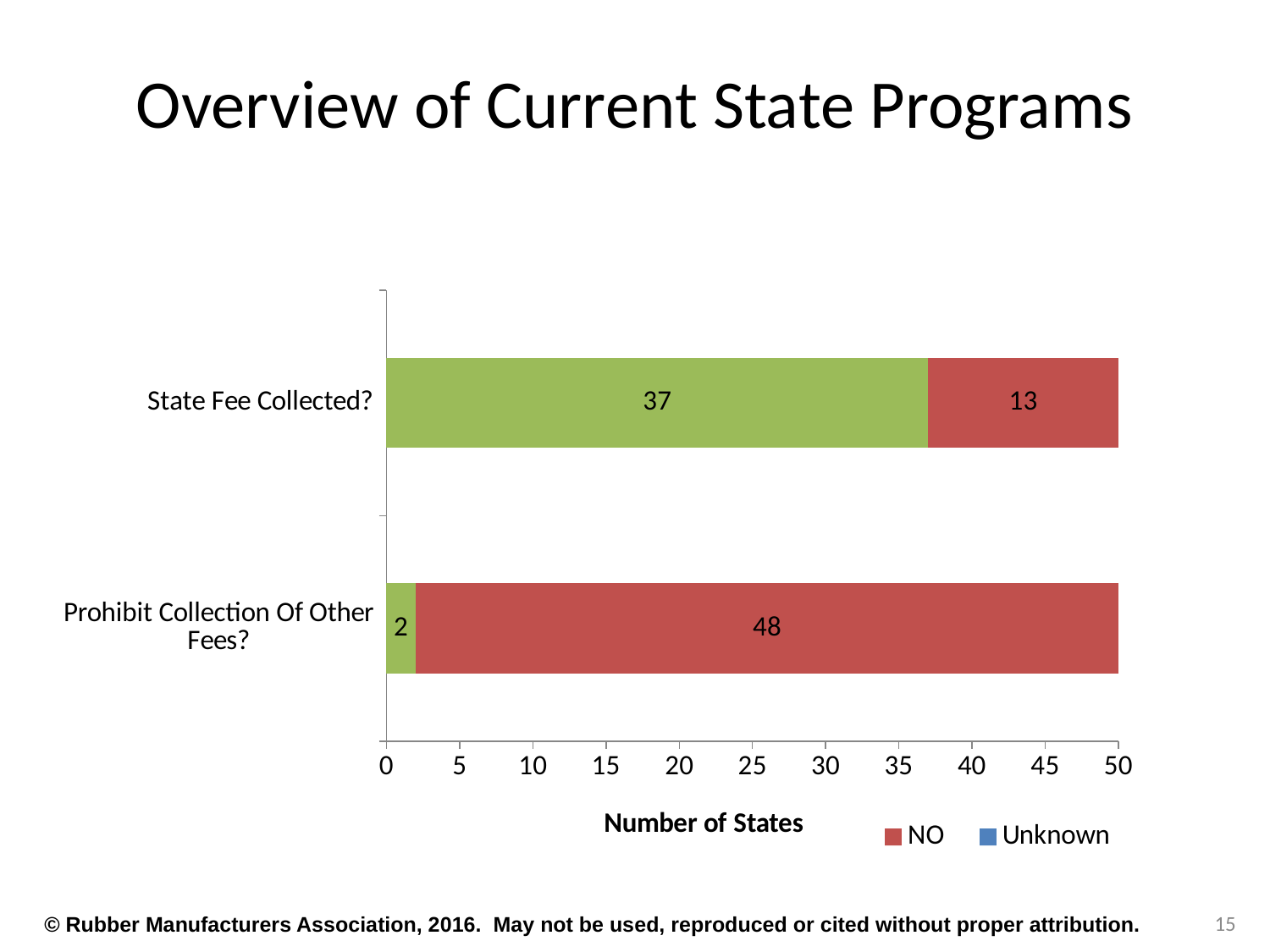
What is the NO value for "Prohibit Collection Of Other Fees?"? 48 What kind of chart is shown on the slide? Stacked bar chart What colour represents the NO series in the legend? Red What is the NO value for "State Fee Collected?"? 13 What value is shown in the green segment of the "Prohibit Collection Of Other Fees?" bar? 2 Which category has the larger NO value, "State Fee Collected?" or "Prohibit Collection Of Other Fees?"? Prohibit Collection Of Other Fees? What value is shown in the green segment of the "State Fee Collected?" bar? 37 How many categories are shown on the chart? 2 What is the difference between the NO values for "Prohibit Collection Of Other Fees?" and "State Fee Collected?"? 35 What is the title of the horizontal axis? Number of States What is the total of the stacked bar for "Prohibit Collection Of Other Fees?"? 50 What is the total of the stacked bar for "State Fee Collected?"? 50